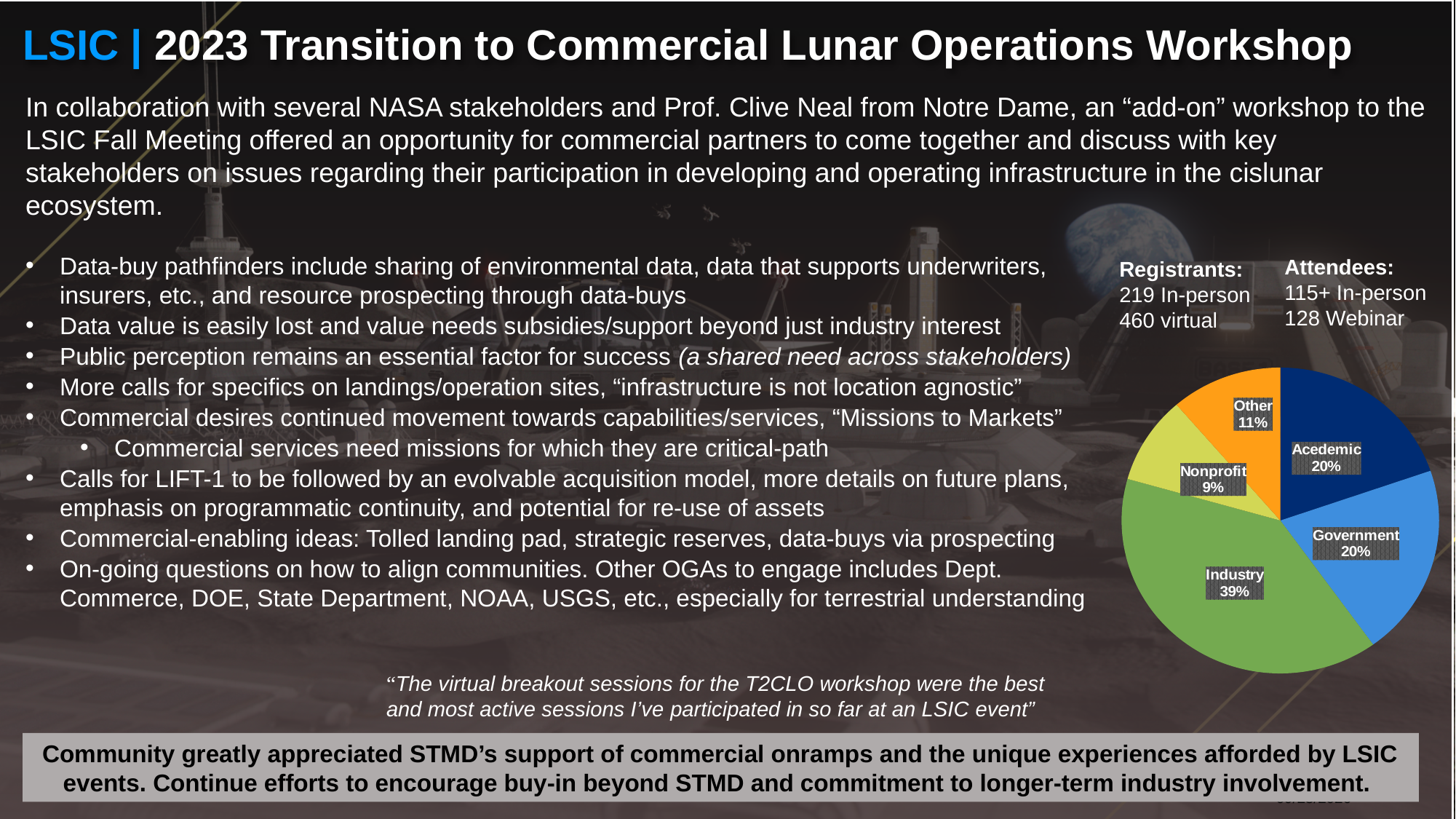
What is the difference in percentage points between the Industry slice and the Government slice? 19 What share of the pie does Government represent? 20% Which slice of the pie chart is the smallest? Nonprofit What is the difference in percentage points between the Other slice and the Nonprofit slice? 2 How many slices does the pie chart have? 5 What share of the pie does Industry represent? 39% What share of the pie does Nonprofit represent? 9% What share of the pie does the Other slice represent? 11% Which is larger, the Other slice or the Nonprofit slice? Other Which slice of the pie chart is the largest? Industry What kind of chart is shown on the slide? pie chart What colour is the Industry slice of the pie chart? green